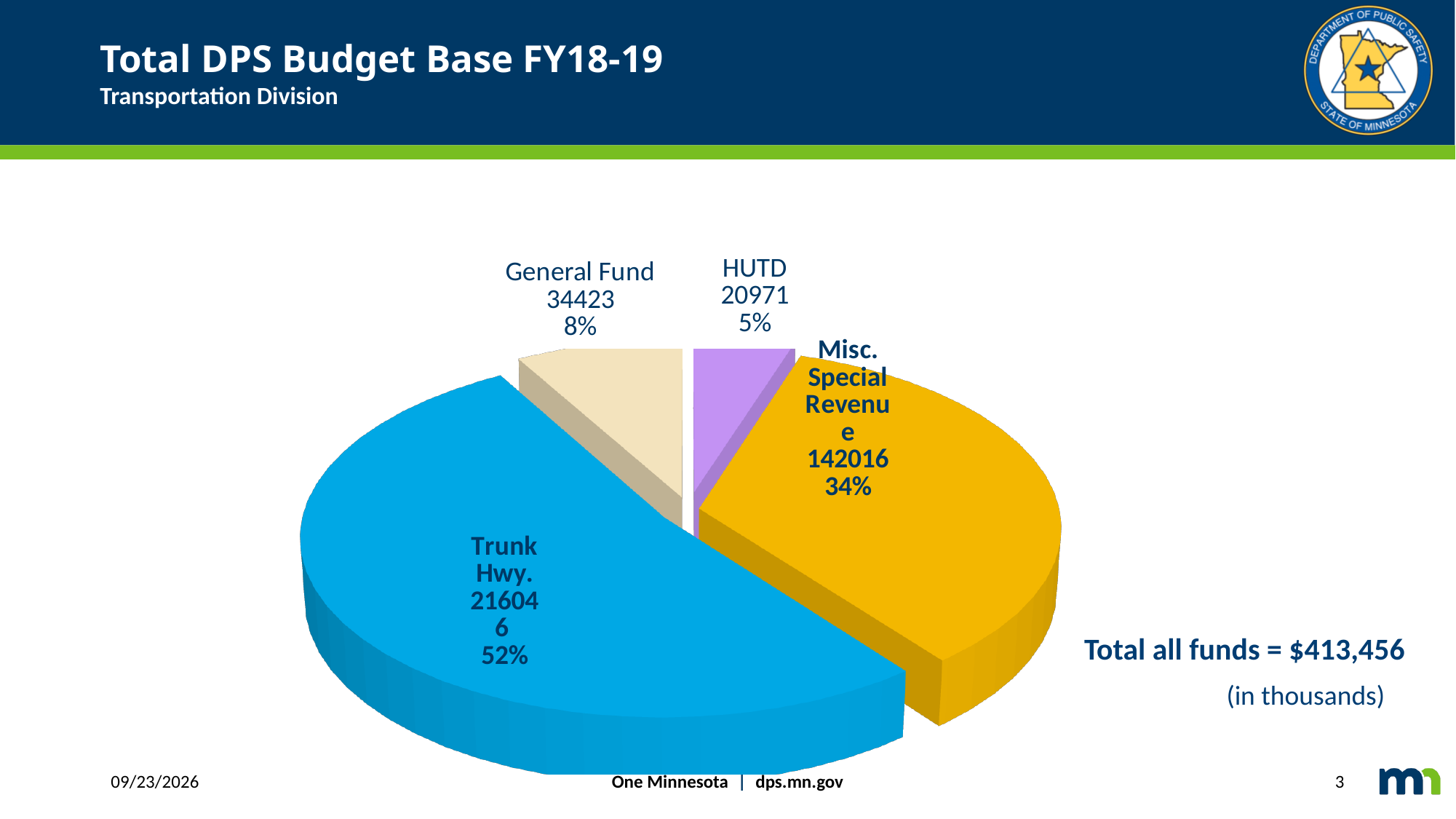
Which category has the smallest slice of the pie? HUTD What kind of chart is shown on the slide? pie chart What share of the pie does HUTD represent? 5% What share of the pie does Trunk Hwy. represent? 52% What is the difference between the General Fund value and the HUTD value? 13452 What is the value shown for Trunk Hwy.? 216046 Which category has the largest slice of the pie? Trunk Hwy. How many slices does the pie chart have? 4 What is the value shown for HUTD? 20971 What is the value shown for Misc. Special Revenue? 142016 What is the total of all funds stated on the slide? $413,456 What is the value shown for General Fund? 34423